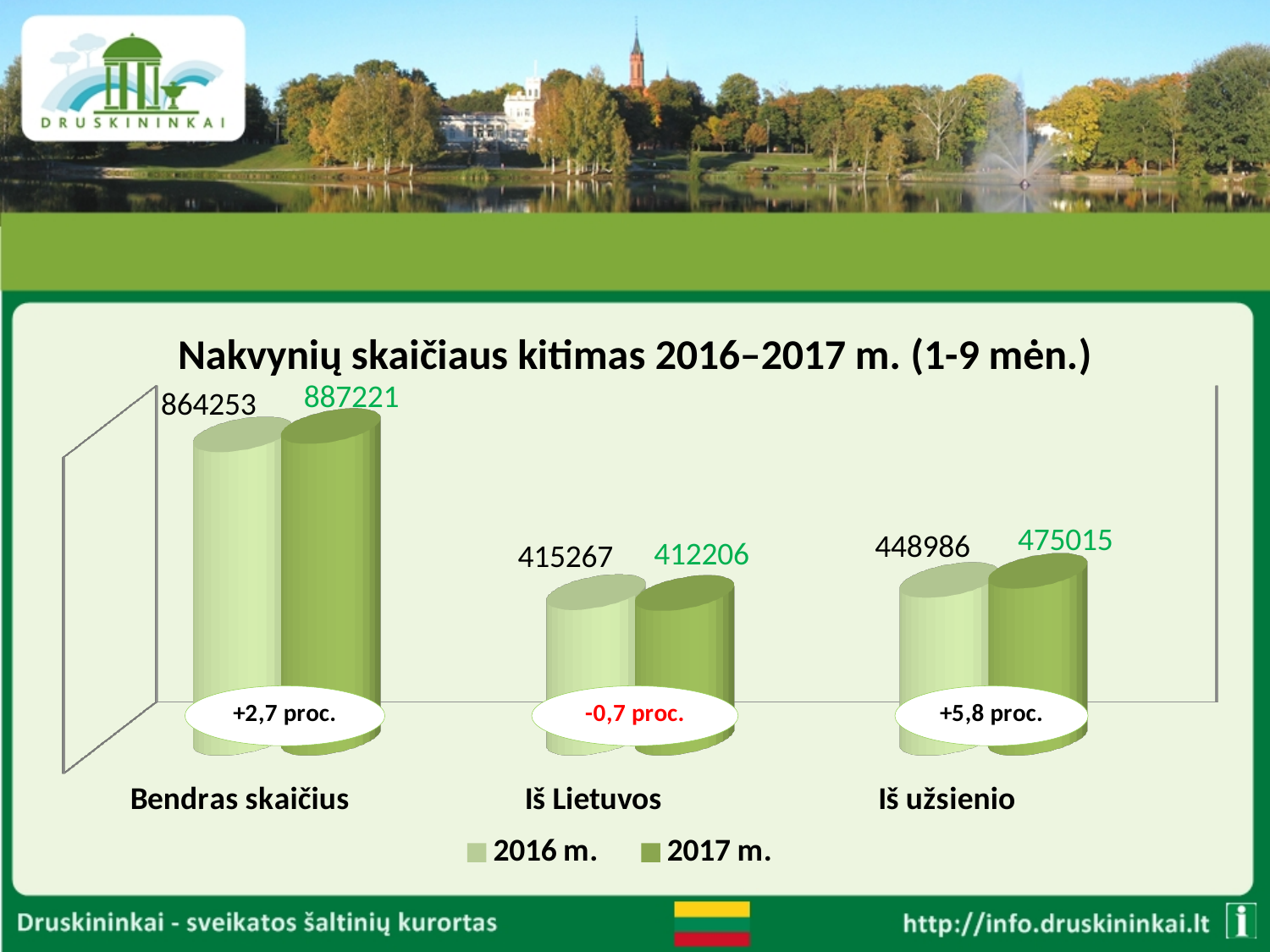
Which category has the highest value for 2017 m.? Bendras skaičius What is the value for 2016 m. in the Bendras skaičius category? 864253 How many series does the legend list? 2 Which category has the lowest value for 2016 m.? Iš Lietuvos Which is larger for Iš Lietuvos: the 2016 m. value or the 2017 m. value? 2016 m. What kind of chart is shown on the slide? Bar chart What is the difference between the 2017 m. and 2016 m. values for Iš užsienio? 26029 What is the value for 2017 m. in the Iš Lietuvos category? 412206 How many categories are shown on the x axis? 3 What is the difference between the 2016 m. and 2017 m. values for Iš Lietuvos? 3061 What percentage change is shown for the Iš užsienio category? +5,8 proc. What is the value for 2017 m. in the Iš užsienio category? 475015